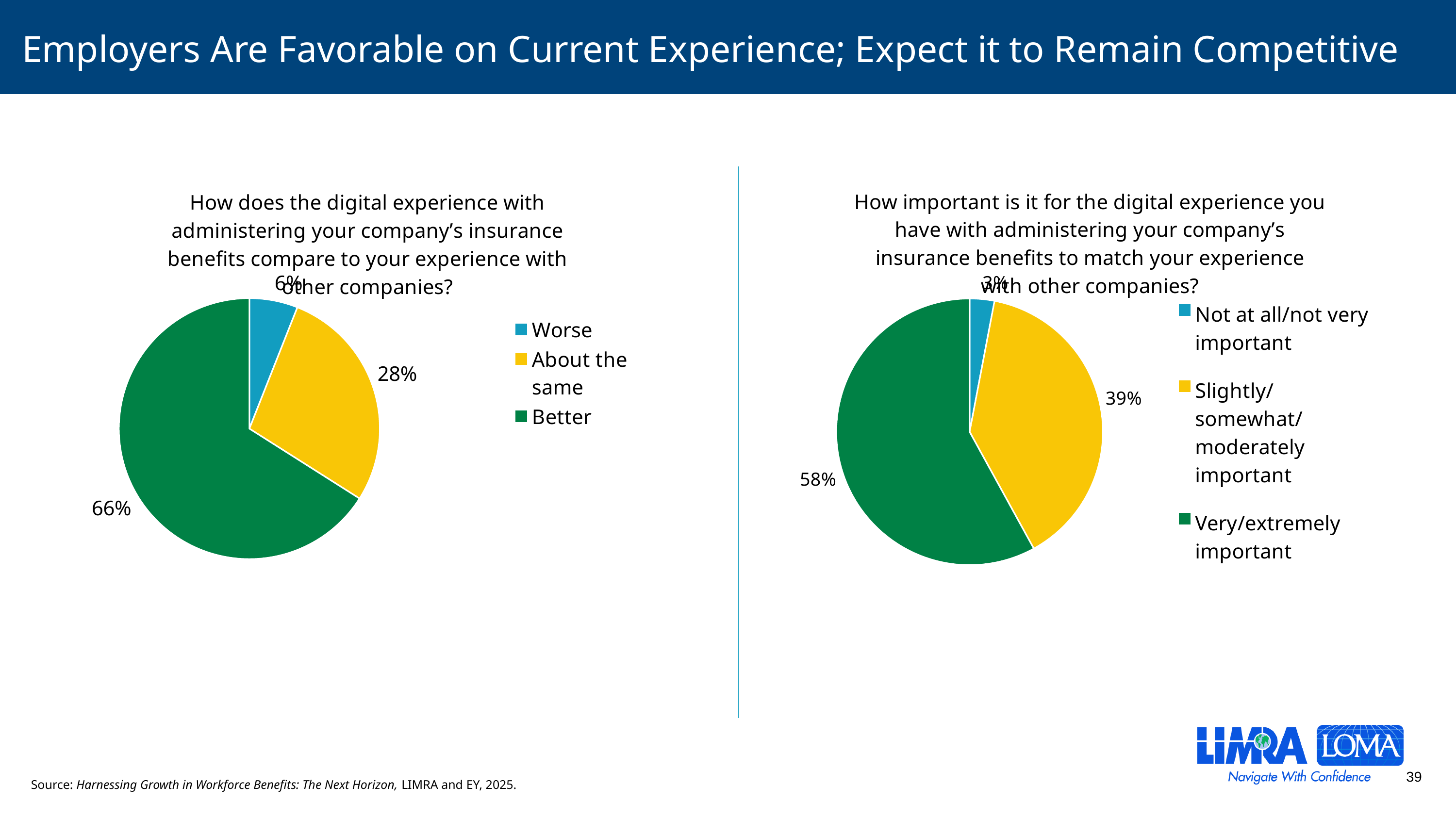
In the left pie chart, what percentage of employers said their digital experience is About the same? 28% In the right pie chart, which is larger: Very/extremely important or Slightly/somewhat/moderately important? Very/extremely important In the left pie chart, which response has the largest share? Better What type of chart is used on the left side of the slide? Pie chart In the left pie chart, how many percentage points larger is the Better share than the About the same share? 38 How many categories does the legend of the right pie chart list? 3 In the right pie chart, how many percentage points larger is Very/extremely important than Slightly/somewhat/moderately important? 19 In the right pie chart, which response has the smallest share? Not at all/not very important In the left pie chart, what percentage of employers said their digital experience is Better? 66% In the left pie chart, what percentage of employers said their digital experience is Worse? 6% In the right pie chart, what share of employers said matching the experience is Slightly/somewhat/moderately important? 39% In the right pie chart, what share of employers said matching the experience is Very/extremely important? 58%